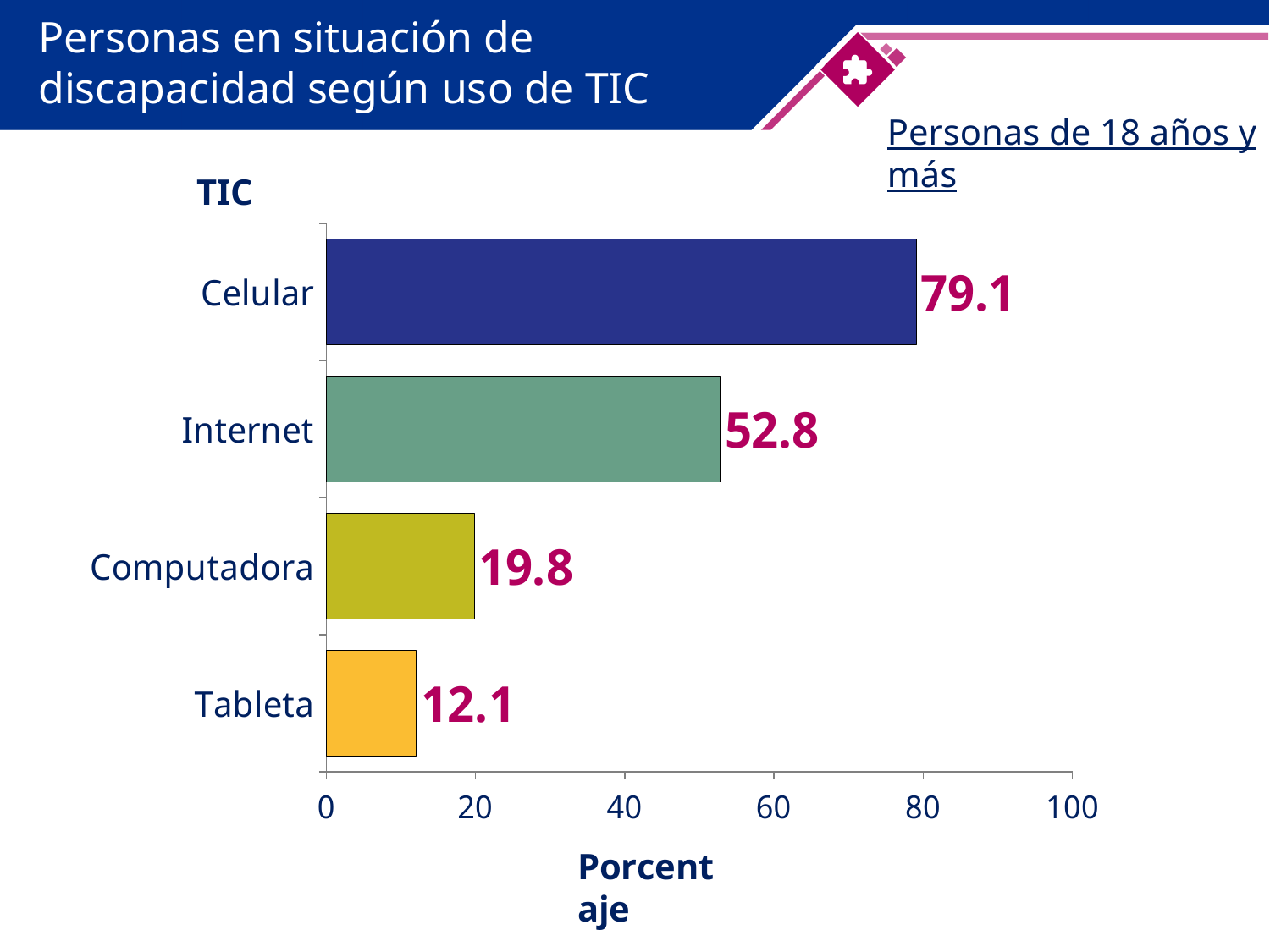
Which TIC category has the highest value? Celular What is the value for Tableta? 12.1 What is the difference between the values for Celular and Internet? 26.3 What is the value for Celular? 79.1 What is the value for Internet? 52.8 Which is larger, the value for Internet or the value for Computadora? Internet What is the value for Computadora? 19.8 How many TIC categories are shown in the chart? 4 Is the value for Internet greater or less than 60? less What is the difference between the values for Computadora and Tableta? 7.7 Which TIC category has the lowest value? Tableta What kind of chart is shown on the slide? bar chart